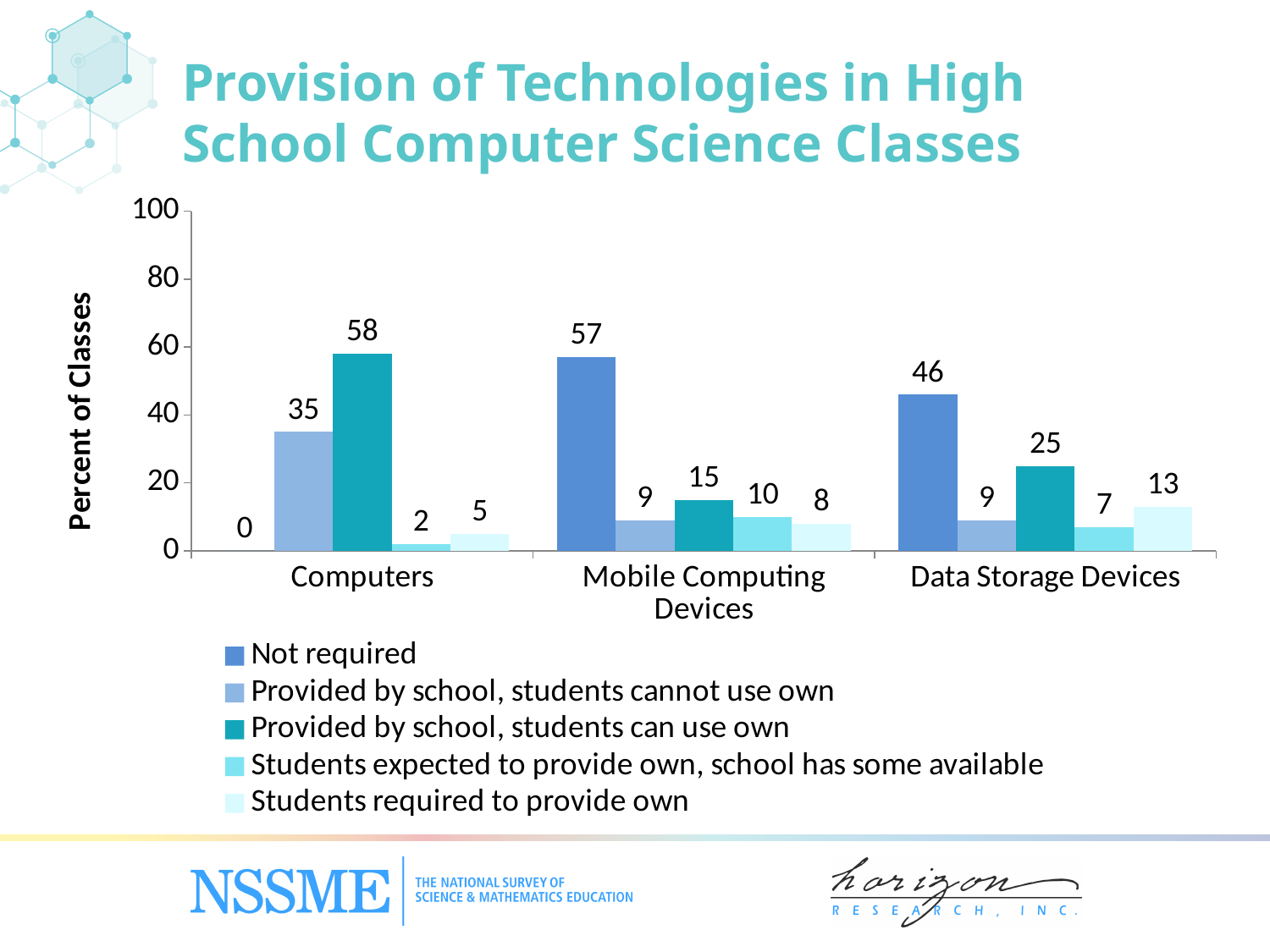
What is the label of the y axis? Percent of Classes What is the difference between the 'Not required' values for Mobile Computing Devices and Data Storage Devices? 11 How many series does the legend list? 5 What kind of chart is shown on the slide? Bar chart Which series has the lowest value for Mobile Computing Devices? Students required to provide own What is the value for 'Students required to provide own' for Data Storage Devices? 13 Is the 'Not required' value for Data Storage Devices greater or less than 40? greater How many technology categories are shown on the x axis? 3 Which series has the highest value for Computers? Provided by school, students can use own What is the value for 'Provided by school, students can use own' for Mobile Computing Devices? 15 Which is larger: 'Provided by school, students cannot use own' for Computers or 'Provided by school, students can use own' for Data Storage Devices? Provided by school, students cannot use own for Computers What percent of classes are in the 'Not required' category for Computers? 0